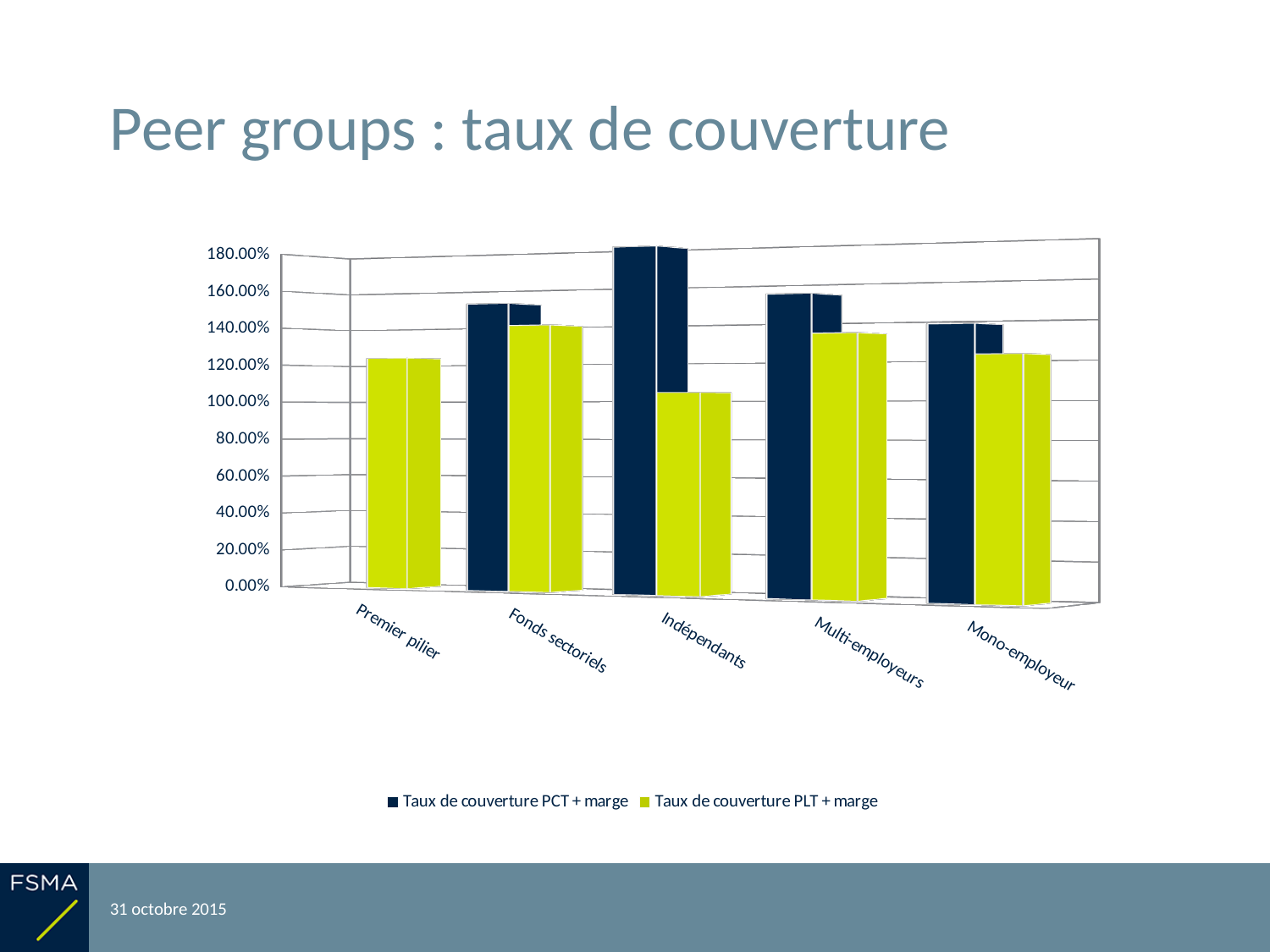
Is the Taux de couverture PLT + marge value for Premier pilier greater or less than 100.00%? greater How many categories are shown on the x axis? 5 Is the Taux de couverture PCT + marge value for Indépendants greater or less than 160.00%? greater How many series does the legend list? 2 Which colour represents Taux de couverture PLT + marge in the legend? Yellow-green Which category has the lowest value for Taux de couverture PLT + marge? Indépendants What kind of chart is shown on the slide? Bar chart Is the Taux de couverture PCT + marge value for Fonds sectoriels greater or less than 140.00%? greater For Indépendants, which is larger: Taux de couverture PCT + marge or Taux de couverture PLT + marge? Taux de couverture PCT + marge Which category has the highest value for Taux de couverture PCT + marge? Indépendants What is the title of the slide's chart? Peer groups : taux de couverture